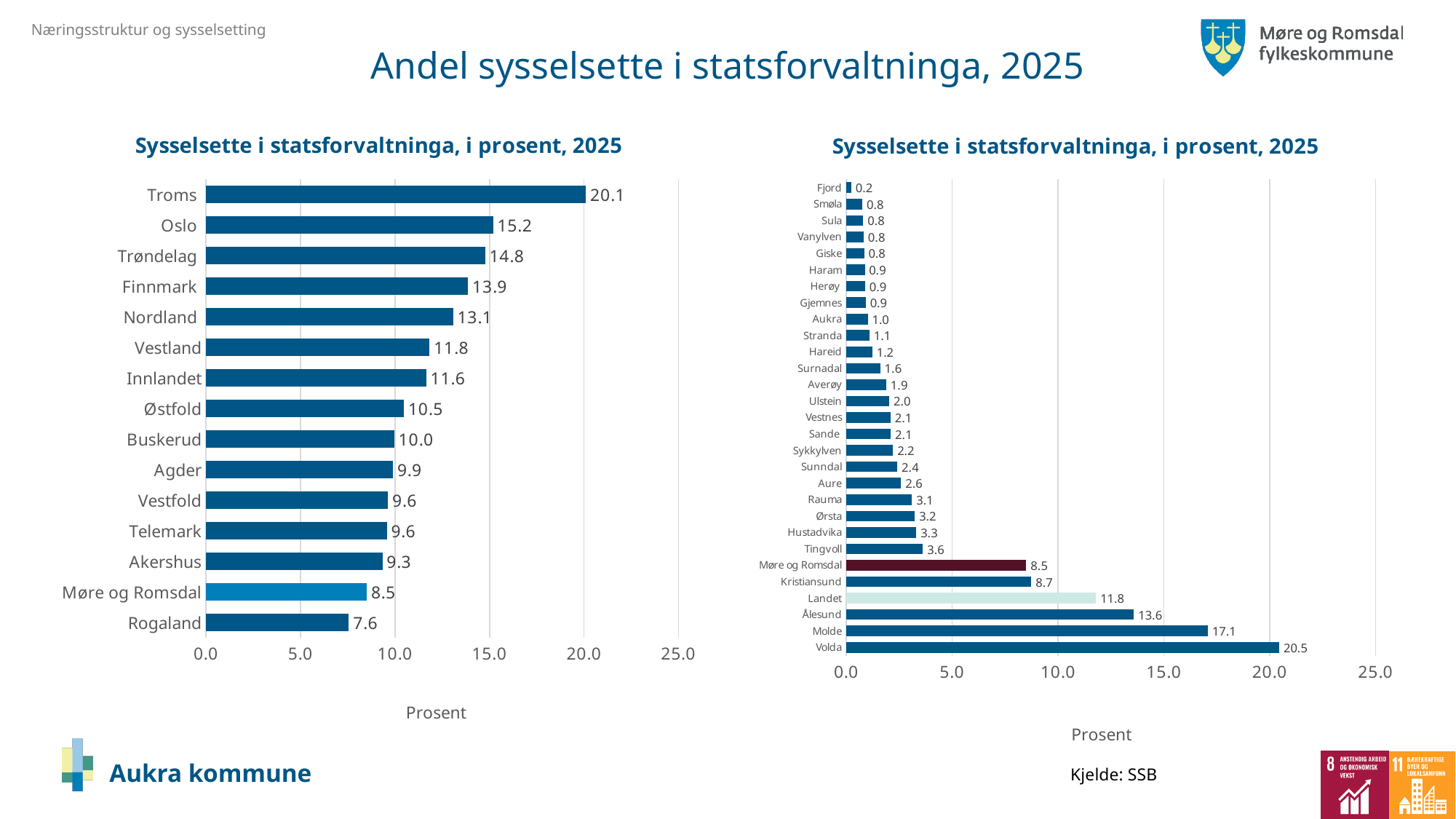
What type of chart is the right chart? Bar chart In the left chart, what is the difference between Oslo and Trøndelag? 0.4 How many categories are shown in the right chart? 29 In the left chart, what is the value for Troms? 20.1 In the right chart, what is the difference between Molde and Ålesund? 3.5 In the left chart, which category has the lowest value? Rogaland In the right chart, what is the value for Landet? 11.8 In the right chart, what is the value for Aukra? 1.0 In the right chart, which category has the highest value? Volda In the left chart, which is larger, Vestland or Innlandet? Vestland How many categories are shown in the left chart? 15 In the left chart, what is the value for Møre og Romsdal? 8.5